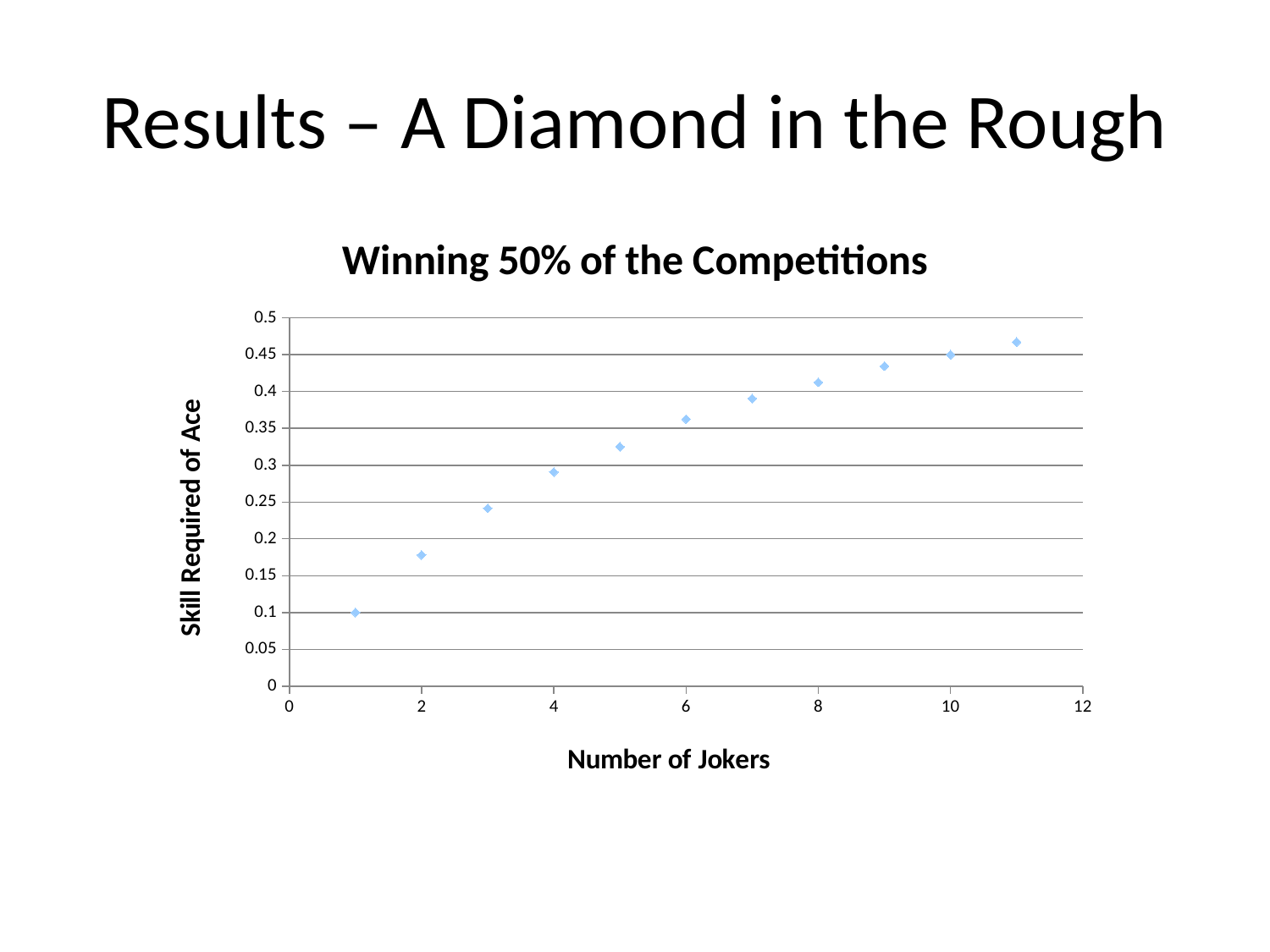
Is the skill required of ace for 4 jokers greater or less than 0.3? less What kind of chart is shown on the slide? scatter chart Is the skill required of ace for 2 jokers greater or less than 0.2? less Is the skill required of ace for 6 jokers greater or less than 0.35? greater What is the label of the y axis? Skill Required of Ace How many data points are plotted on the chart? 11 What is the skill required of ace when the number of jokers is 1? 0.1 At which number of jokers is the skill required of ace lowest? 1 At which number of jokers is the skill required of ace highest? 11 What is the title of the chart? Winning 50% of the Competitions Which requires more skill of the ace: 3 jokers or 7 jokers? 7 jokers Do the values rise or fall as the number of jokers increases? rise